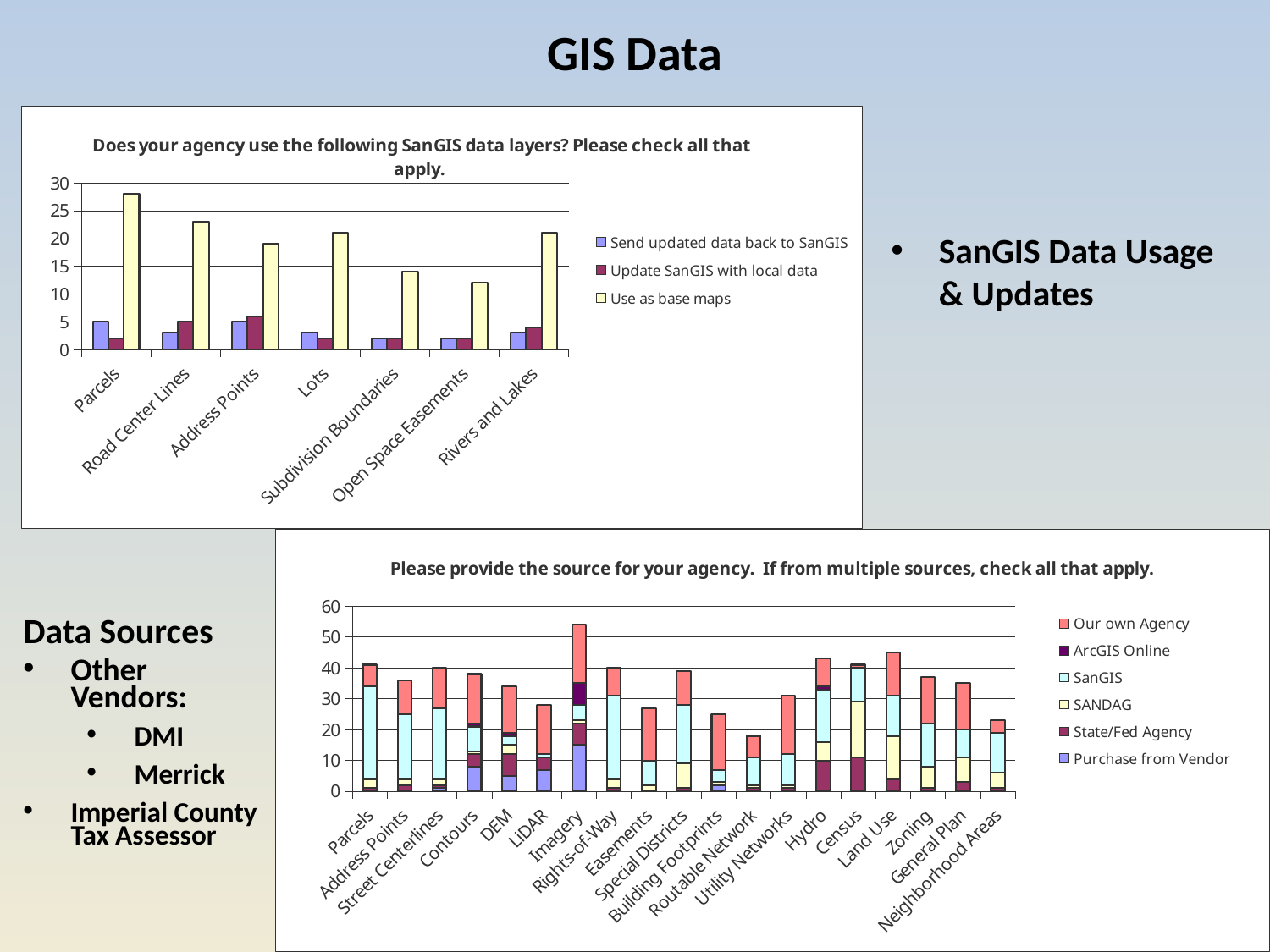
In the top chart, is the 'Use as base maps' value for Parcels greater or less than 25? greater In the top chart, is the 'Use as base maps' value for Open Space Easements greater or less than 15? less How many categories are shown on the x axis of the bottom chart? 19 In the top chart, which is larger: the 'Use as base maps' value for Parcels or for Road Center Lines? Parcels What type of chart is the top chart titled 'Does your agency use the following SanGIS data layers?'? Bar chart How many data layer categories are shown on the x axis of the top chart? 7 What is the title of the bottom chart? Please provide the source for your agency. If from multiple sources, check all that apply. In the bottom chart, which category has the tallest stacked bar? Imagery In the bottom chart, is the total stacked value for Imagery greater or less than 50? greater In the top chart, which data layer has the highest 'Use as base maps' value? Parcels How many series does the legend of the bottom chart list? 6 How many series does the legend of the top chart list? 3